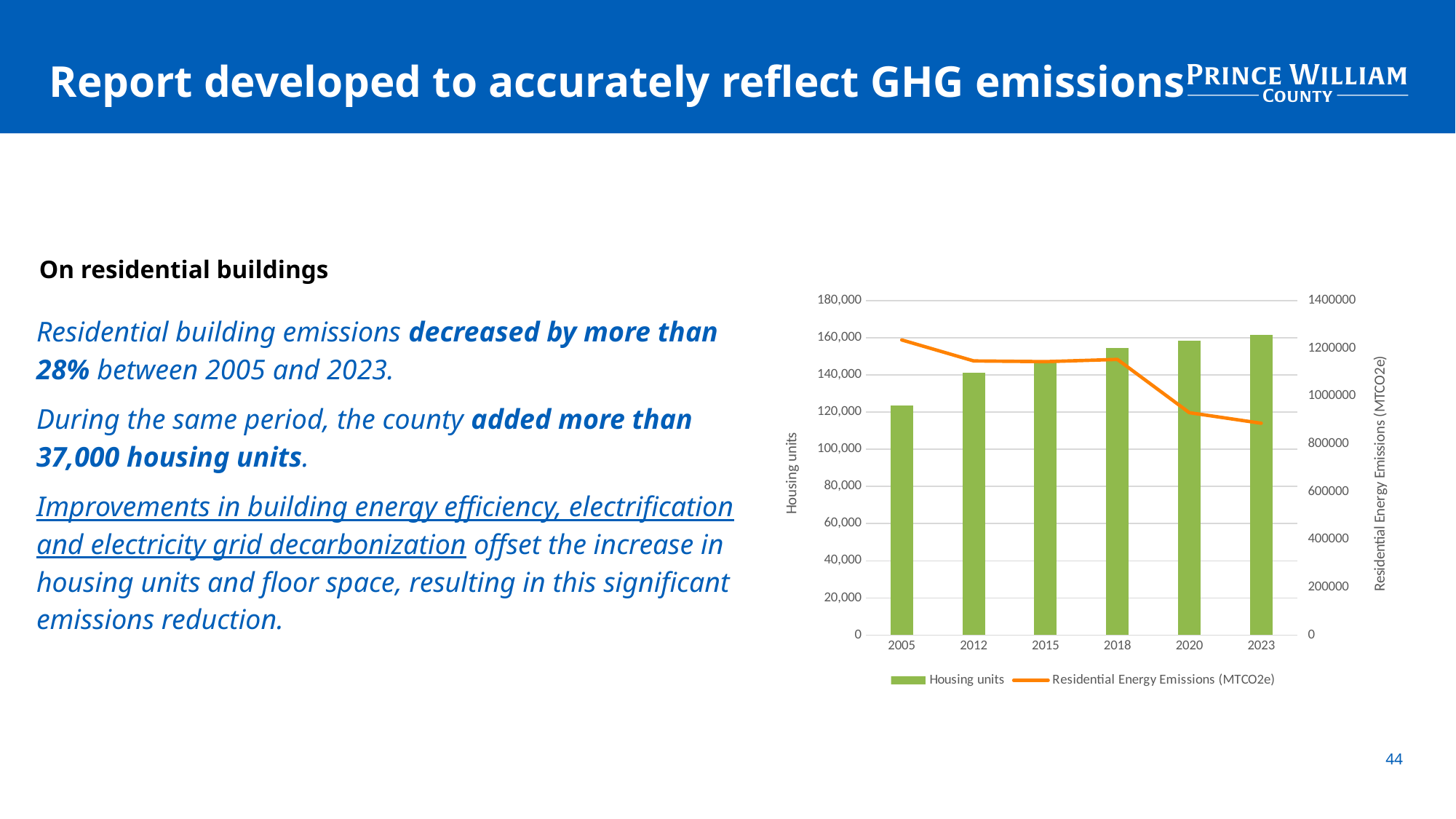
Are residential energy emissions in 2023 greater or less than 1000000 MTCO2e? less Is the number of housing units in 2005 greater or less than 140,000? less What is the label of the right-hand vertical axis? Residential Energy Emissions (MTCO2e) What kind of chart is shown on the slide? Combined bar and line chart Do housing units rise or fall from 2005 to 2023? Rise Which year has the lowest number of housing units? 2005 Do residential energy emissions rise or fall from 2005 to 2023? Fall Which year has the highest number of housing units? 2023 How many series does the chart's legend list? 2 How many years are shown on the x axis of the chart? 6 Which year has higher residential energy emissions, 2005 or 2020? 2005